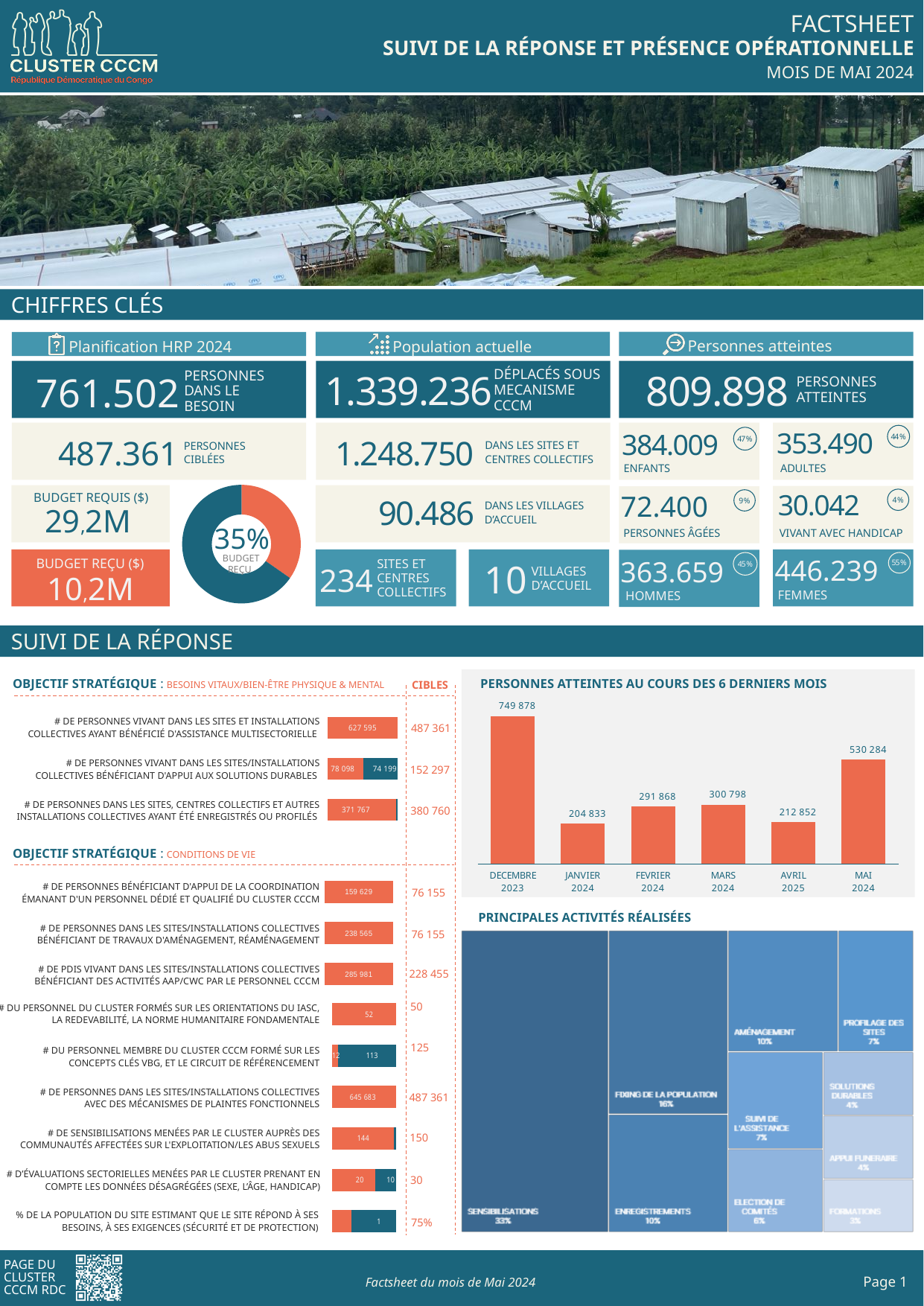
How many months are shown in the chart 'PERSONNES ATTEINTES AU COURS DES 6 DERNIERS MOIS'? 6 In the chart 'PERSONNES ATTEINTES AU COURS DES 6 DERNIERS MOIS', which month has the lowest value? JANVIER 2024 In the chart 'PRINCIPALES ACTIVITÉS RÉALISÉES', what percentage is shown for SENSIBILISATIONS? 33% What kind of chart is 'PERSONNES ATTEINTES AU COURS DES 6 DERNIERS MOIS'? Bar chart In the chart 'PERSONNES ATTEINTES AU COURS DES 6 DERNIERS MOIS', which month has the highest value? DECEMBRE 2023 In the chart 'PRINCIPALES ACTIVITÉS RÉALISÉES', which activity has the largest share? SENSIBILISATIONS In the chart 'PERSONNES ATTEINTES AU COURS DES 6 DERNIERS MOIS', what is the difference between the values for MARS 2024 and FEVRIER 2024? 8 930 In the chart 'PERSONNES ATTEINTES AU COURS DES 6 DERNIERS MOIS', which is larger: the value for AVRIL 2025 or the value for JANVIER 2024? AVRIL 2025 In the chart 'PERSONNES ATTEINTES AU COURS DES 6 DERNIERS MOIS', what is the value for MAI 2024? 530 284 In the donut chart next to 'BUDGET REQUIS' and 'BUDGET REÇU', what percentage of the budget has been received (BUDGET REÇU)? 35% In the chart 'PERSONNES ATTEINTES AU COURS DES 6 DERNIERS MOIS', what is the difference between the values for DECEMBRE 2023 and MAI 2024? 219 594 In the chart 'PERSONNES ATTEINTES AU COURS DES 6 DERNIERS MOIS', what is the value for DECEMBRE 2023? 749 878